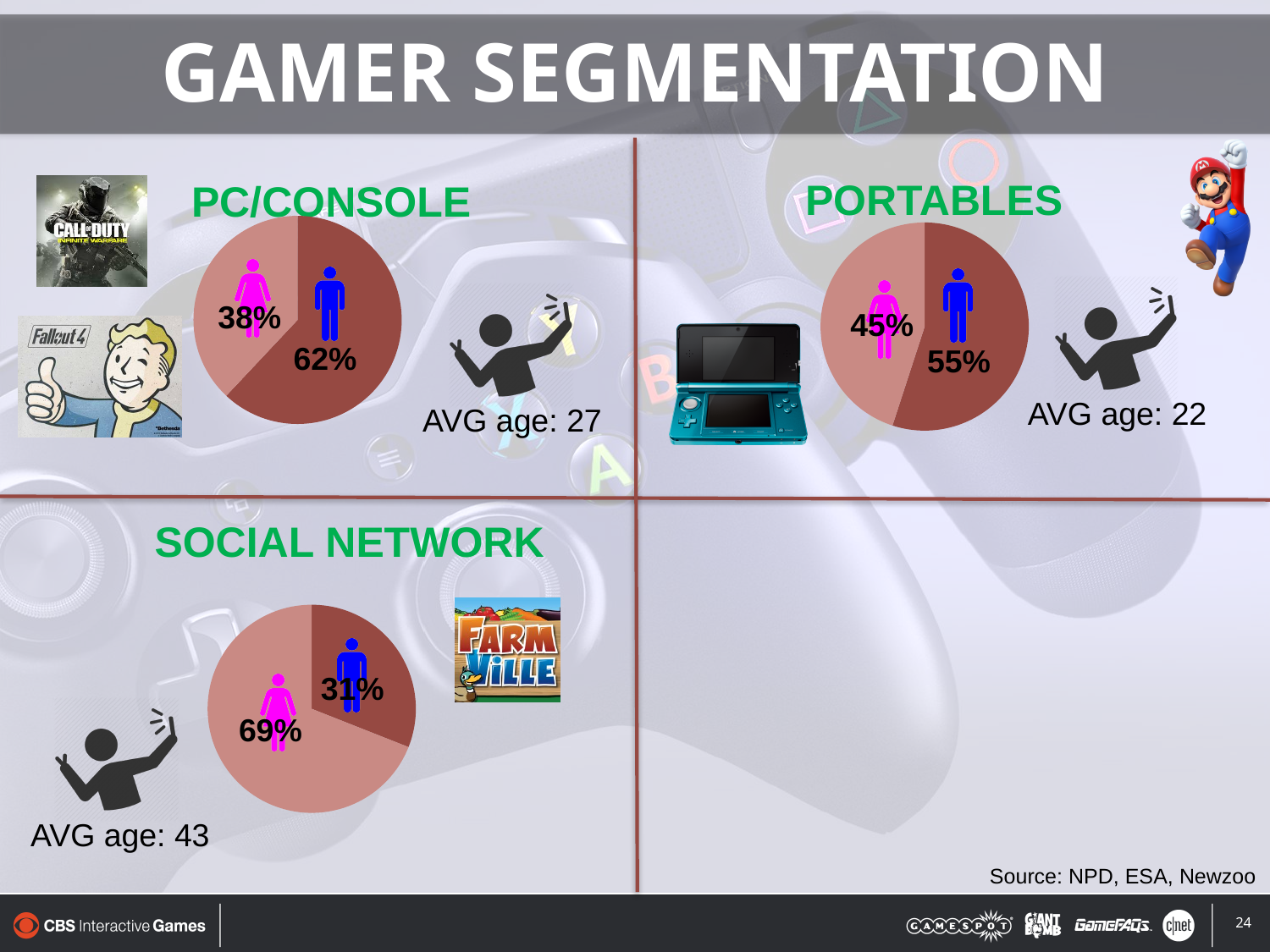
What kind of chart is used for the SOCIAL NETWORK segment? Pie chart In the PORTABLES pie chart, what is the difference between the male and female shares? 10% In the PC/CONSOLE pie chart, what is the difference between the male and female shares? 24% How many pie charts are shown on the slide? 3 In the SOCIAL NETWORK pie chart, what share of gamers is male? 31% In the SOCIAL NETWORK pie chart, which group has the larger share, male or female? Female In the PC/CONSOLE pie chart, which group has the larger share, male or female? Male In the PORTABLES pie chart, what share of gamers is female? 45% In the PC/CONSOLE pie chart, what share of gamers is male? 62% In the PC/CONSOLE pie chart, what share of gamers is female? 38% In the PORTABLES pie chart, what share of gamers is male? 55% In the SOCIAL NETWORK pie chart, what share of gamers is female? 69%